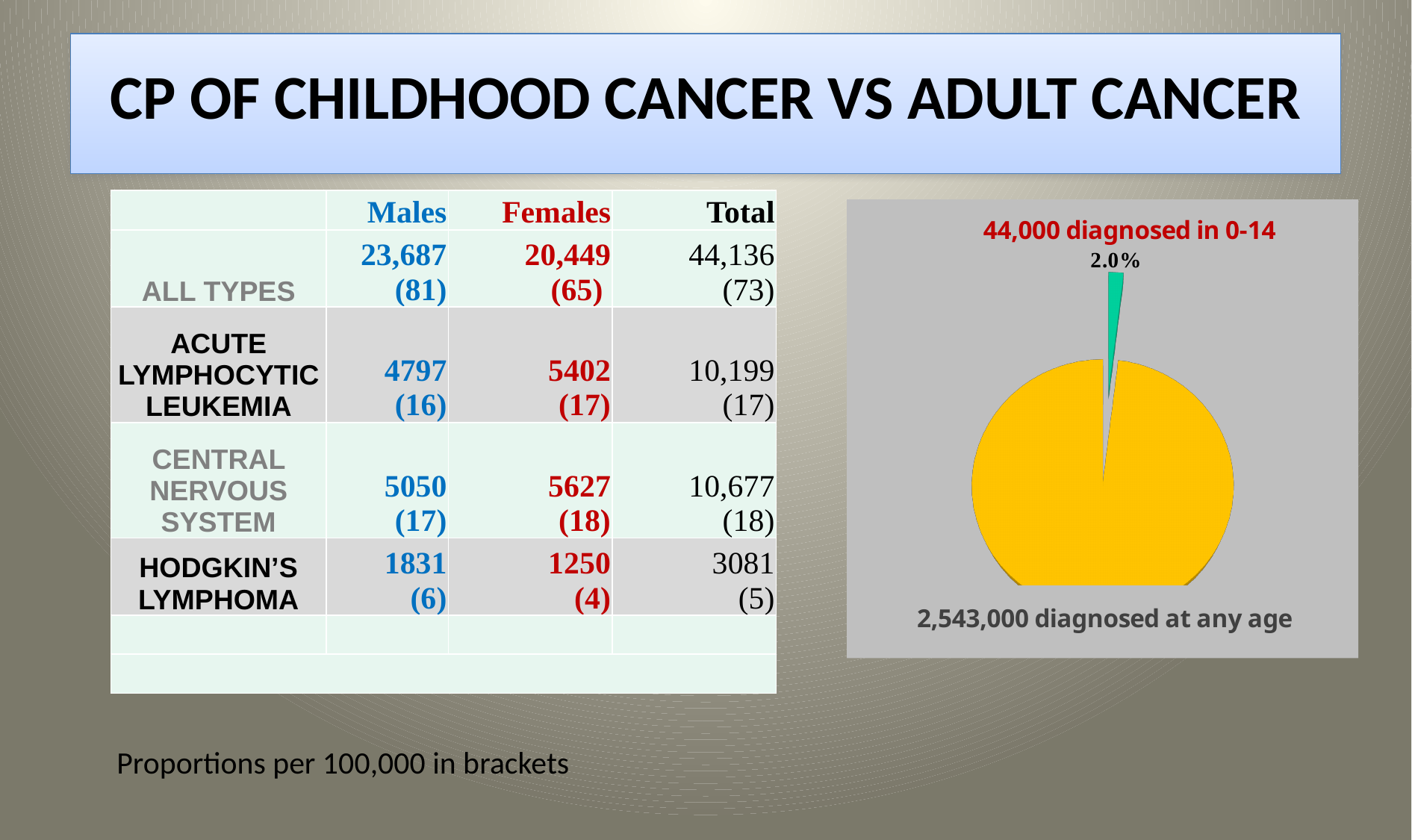
How many slices does the pie chart have? 2 What text is printed in red above the pie chart? 44,000 diagnosed in 0-14 In the pie chart, which slice is larger, the green slice or the yellow slice? the yellow slice What text is printed below the pie chart? 2,543,000 diagnosed at any age In the pie chart, which group does the smallest slice represent? diagnosed in 0-14 In the pie chart, which group does the largest slice represent? diagnosed at any age What kind of chart is shown on the right side of the slide? pie chart In the pie chart, what percentage is printed on the small green slice? 2.0%